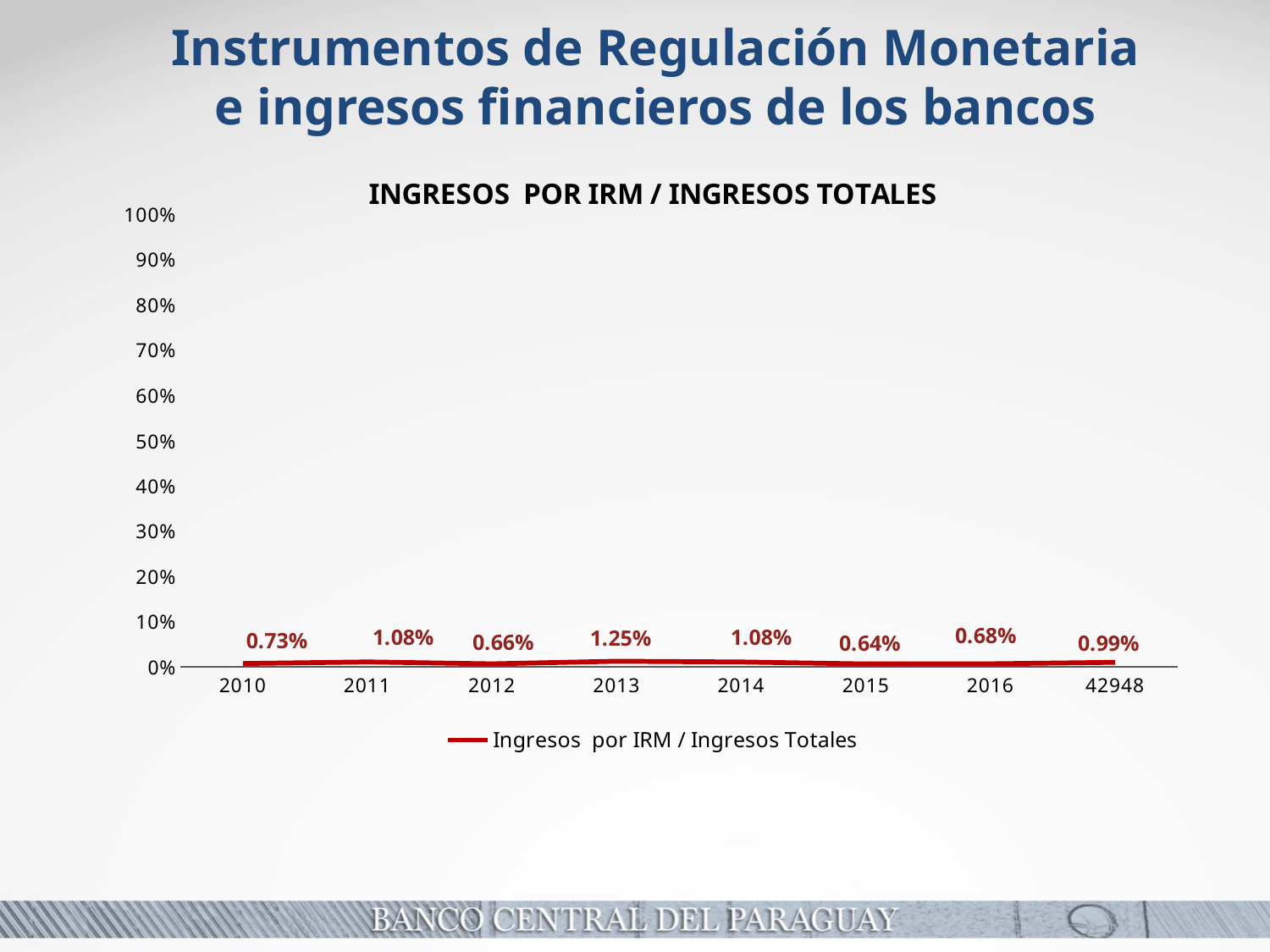
Which is larger, the value for 2011 or the value for 2012? 2011 What is the value for 2015 in the chart? 0.64% How many data points are plotted in the chart? 8 What is the title of the chart? INGRESOS POR IRM / INGRESOS TOTALES Is the value for 2014 greater or less than 10%? less Which year has the lowest value in the chart? 2015 Which year has the highest value in the chart? 2013 What is the value for the last category, labelled 42948? 0.99% What is the value for 2010 in the chart? 0.73% What is the difference between the values for 2013 and 2015? 0.61% What kind of chart is shown on the slide? line chart What is the value for 2013 in the chart? 1.25%